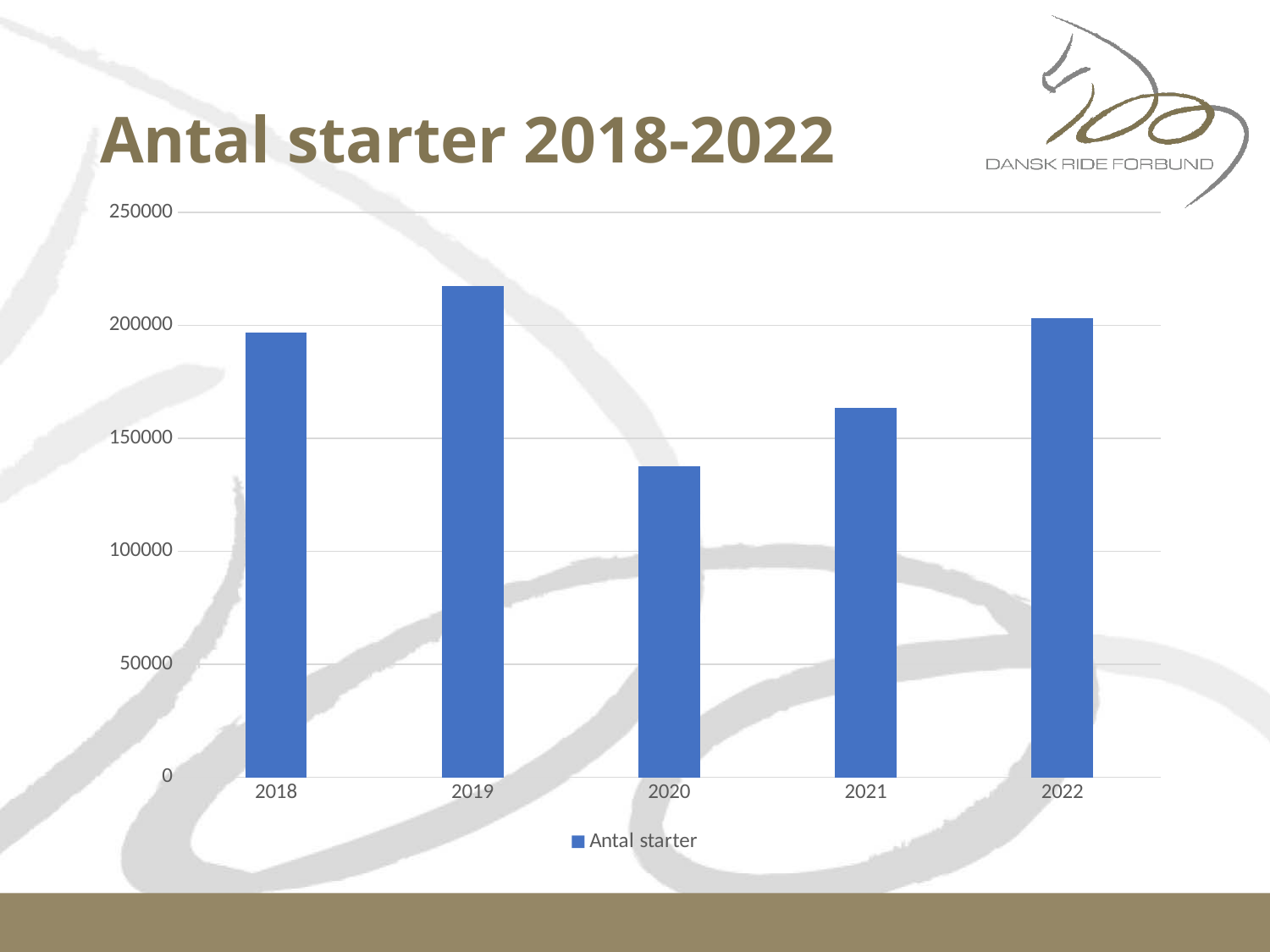
What kind of chart is shown on the slide? bar chart Is the value for 2019 greater or less than 200000? greater Which year has the highest number of starts? 2019 What is the name of the series shown in the legend? Antal starter Which year has more starts, 2021 or 2020? 2021 What is the title of the chart? Antal starter 2018-2022 Do the values rise or fall from 2020 to 2022? rise Which year has more starts, 2019 or 2018? 2019 How many years are shown on the x axis of the chart? 5 How many series does the legend list? 1 Is the value for 2020 greater or less than 150000? less Which year has the lowest number of starts? 2020